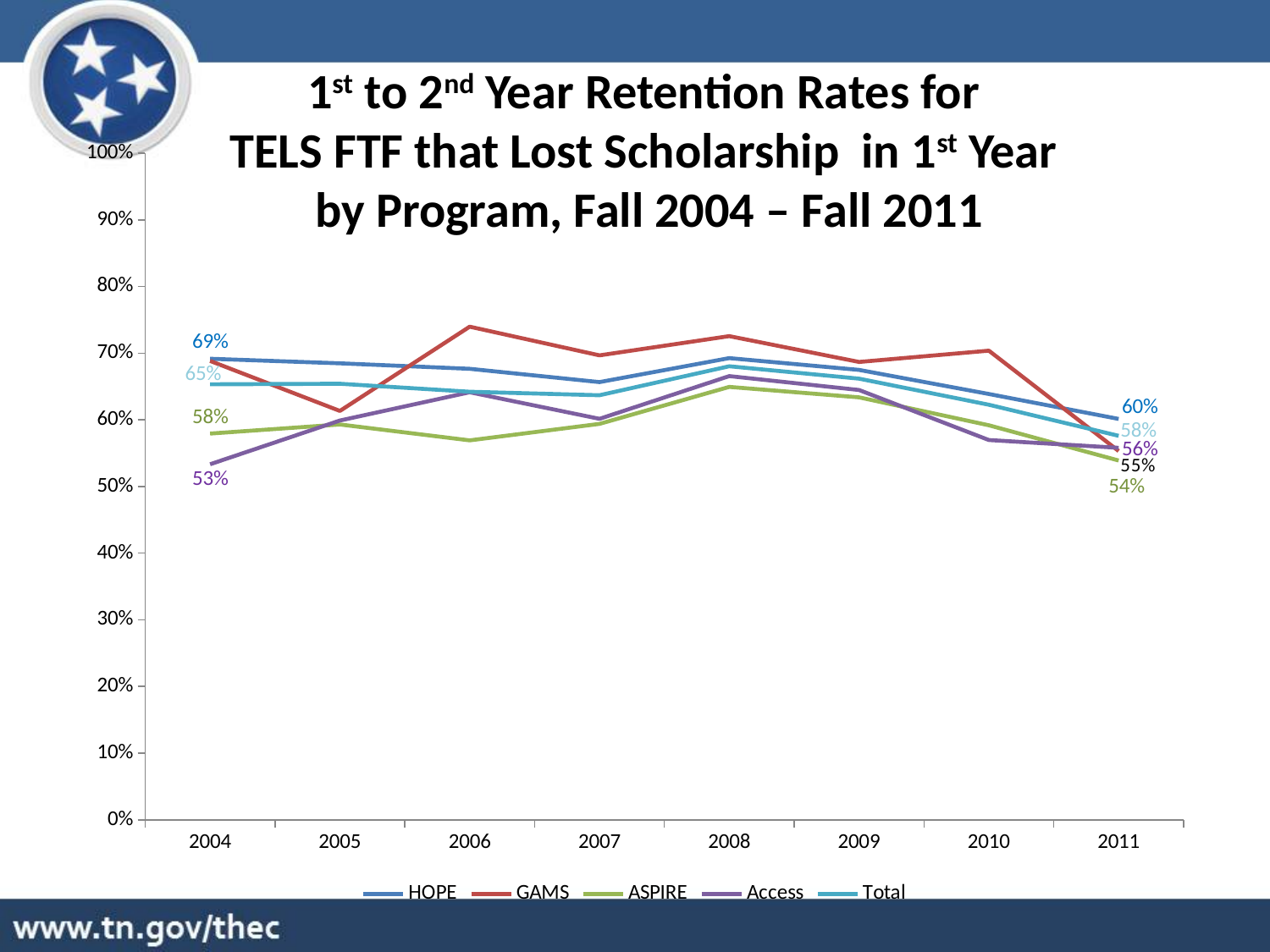
What is the Total retention rate in 2011? 58% Which program had the lowest retention rate in 2004? Access What is the retention rate for ASPIRE in 2011? 54% In 2004, which had the higher retention rate, HOPE or ASPIRE? HOPE What is the retention rate for HOPE in 2004? 69% Is the GAMS retention rate in 2006 greater or less than 70%? greater What kind of chart is shown on the slide? Line chart By how many percentage points did the HOPE retention rate fall from 2004 to 2011? 9 percentage points What is the retention rate for Access in 2004? 53% How many years are shown on the x axis? 8 How many series does the legend list? 5 Is the Access retention rate in 2010 greater or less than 60%? less